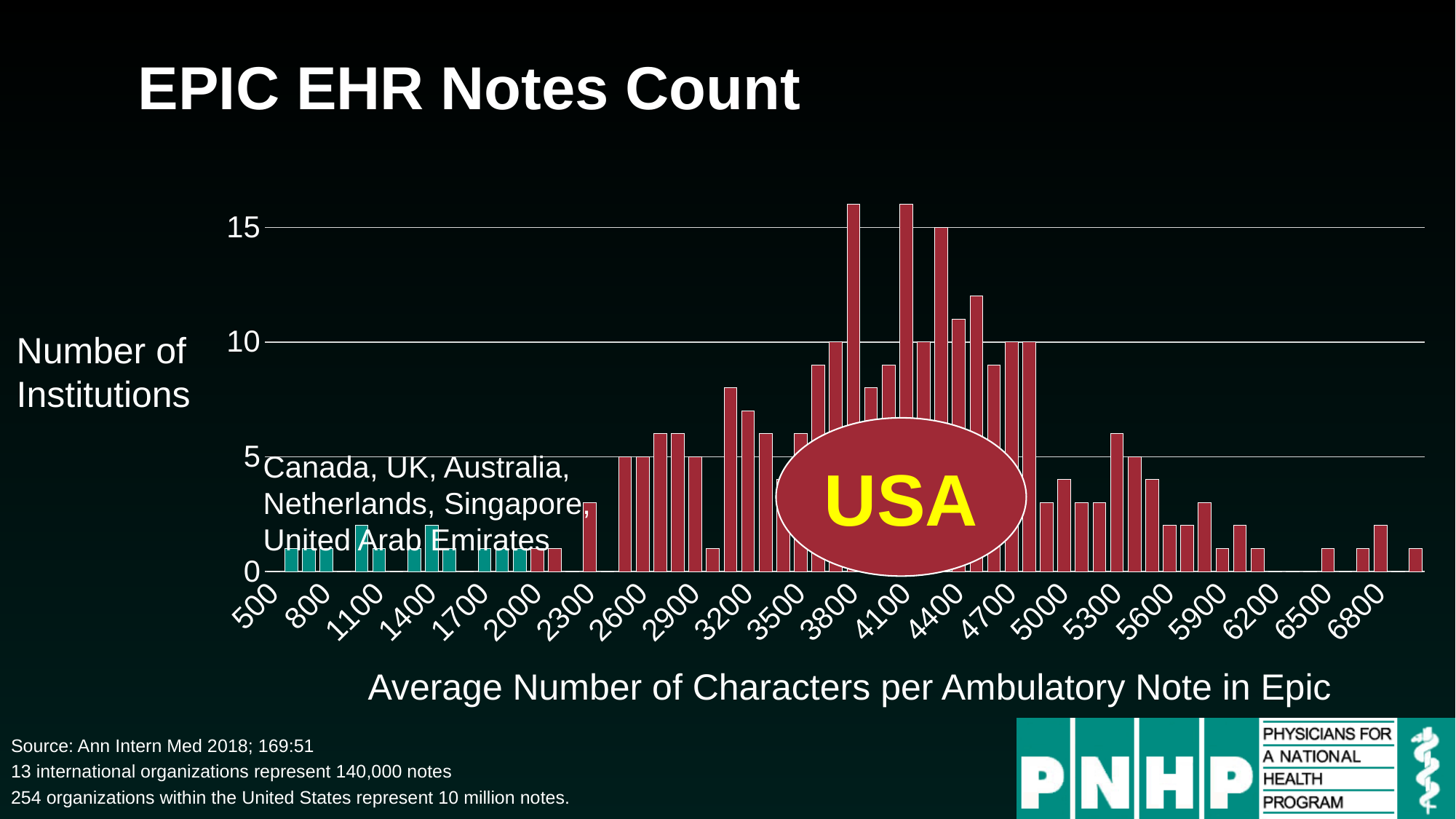
Do the values generally rise or fall along the x axis from 4700 to 6800? fall What is the title of the chart? EPIC EHR Notes Count Is the value for 3800 greater or less than 5? greater Is the value for 500 greater or less than 5? less Which group, the international institutions (teal bars) or the USA (dark red bars), has the highest bar? USA Is the value for 6800 greater or less than 5? less Do the values generally rise or fall along the x axis from 2300 to 3800? rise What kind of chart is shown on the slide? bar chart Which is larger, the value for 3800 or the value for 800? 3800 Which group of institutions is represented by the dark red bars? USA